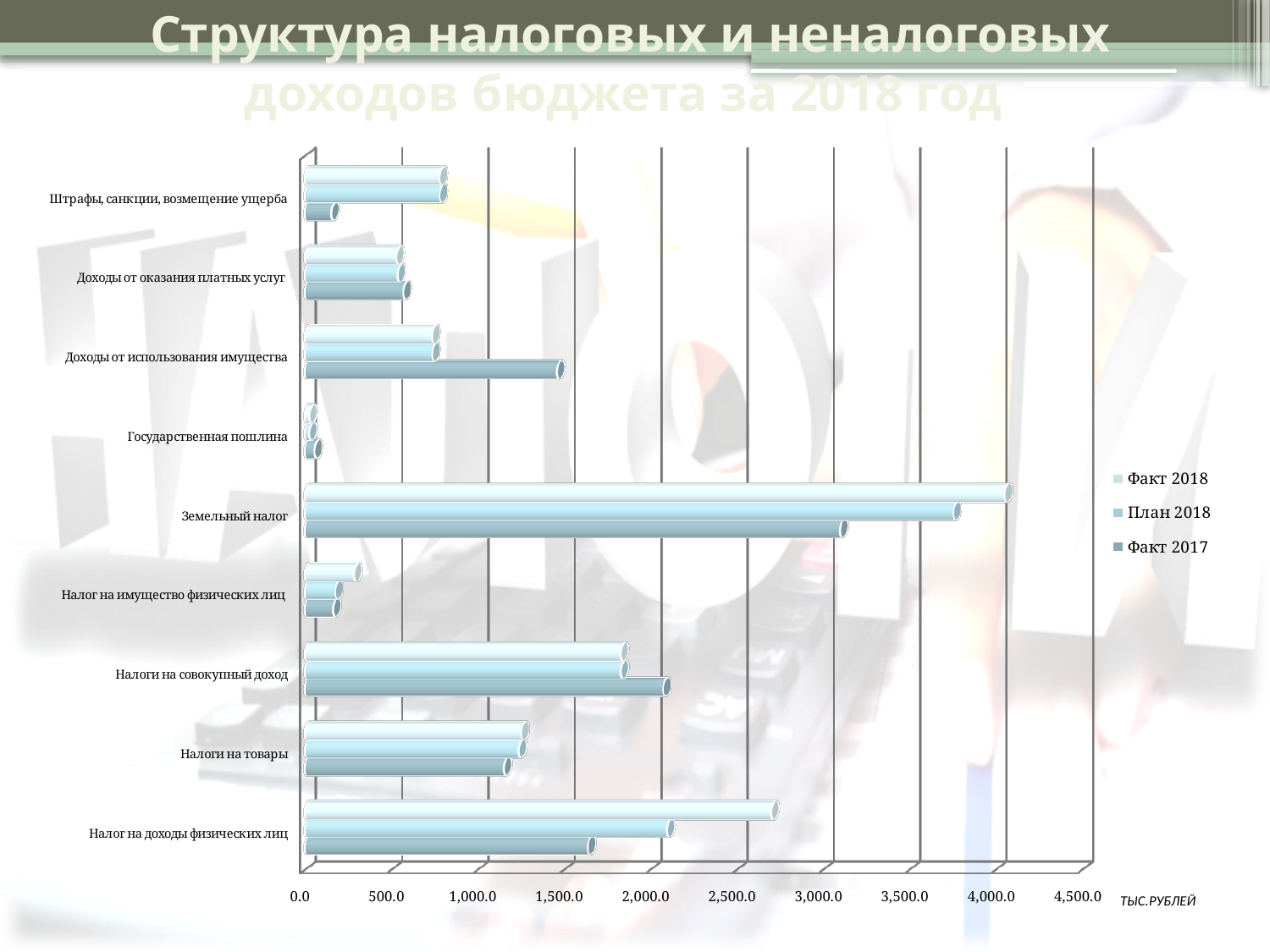
For Доходы от использования имущества, which is larger: Факт 2017 or Факт 2018? Факт 2017 Which category has the highest value for Факт 2018? Земельный налог What kind of chart is shown on the slide? Bar chart Is the Факт 2017 value for Государственная пошлина greater or less than 500.0? less Is the Факт 2018 value for Земельный налог greater or less than 3,500.0? greater How many series does the legend list? 3 Is the Факт 2018 value for Налоги на совокупный доход greater or less than 2,000.0? less Which category has the lowest values across all series? Государственная пошлина For Налог на доходы физических лиц, which is larger: Факт 2018 or План 2018? Факт 2018 How many categories are plotted on the chart? 9 What unit is indicated next to the horizontal axis? ТЫС.РУБЛЕЙ